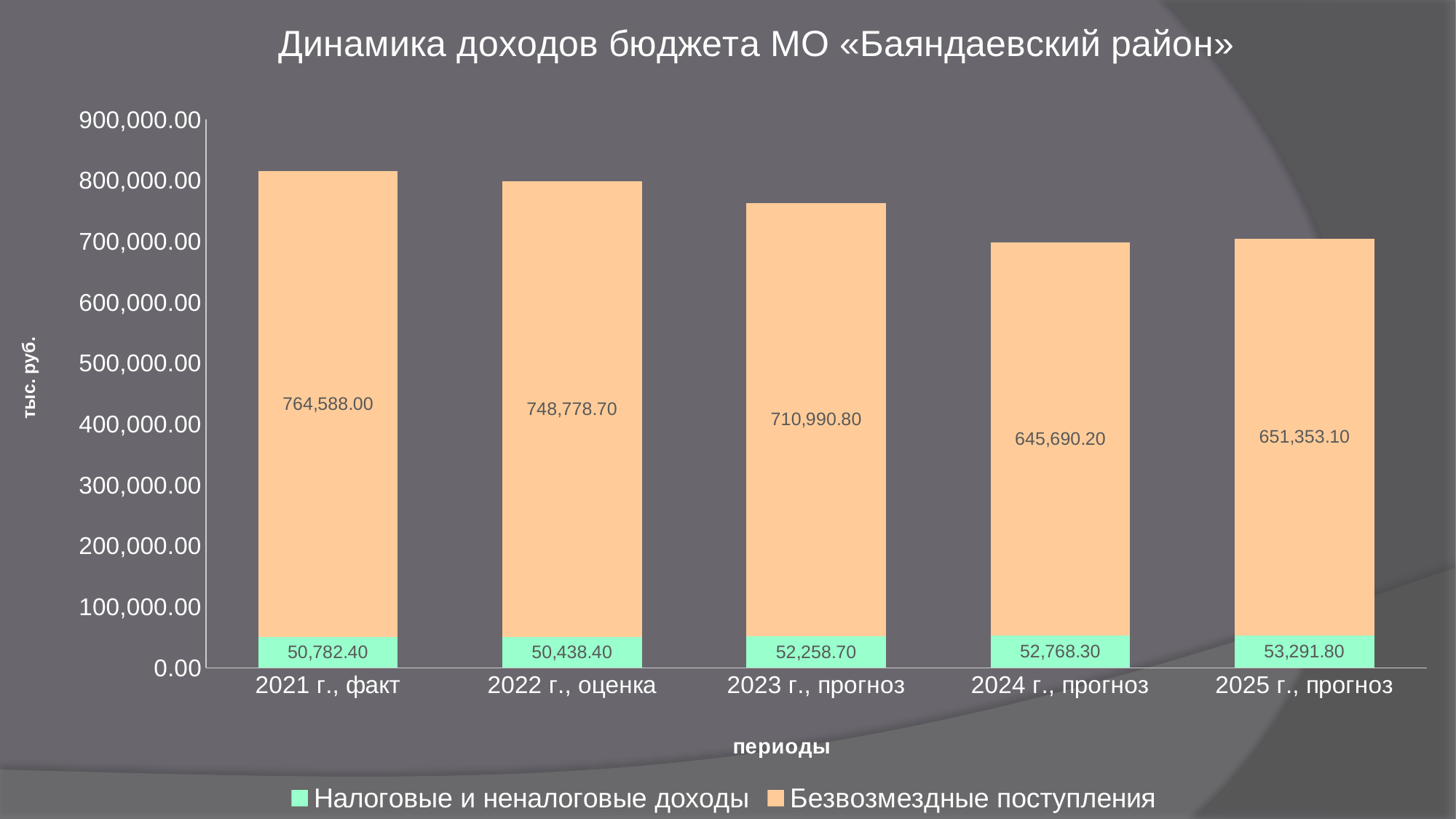
How many periods (categories) are shown on the x axis? 5 What is the value of Налоговые и неналоговые доходы for 2022 г., оценка? 50,438.40 In which period is Безвозмездные поступления the highest? 2021 г., факт What kind of chart is shown on the slide? Stacked bar chart In which period is Безвозмездные поступления the lowest? 2024 г., прогноз What is the total of the stacked bar for 2021 г., факт? 815,370.40 What is the difference between Безвозмездные поступления in 2021 г., факт and 2022 г., оценка? 15,809.30 In which period is Налоговые и неналоговые доходы the highest? 2025 г., прогноз Which is larger: Безвозмездные поступления in 2024 г., прогноз or in 2025 г., прогноз? 2025 г., прогноз What is the value of Безвозмездные поступления for 2023 г., прогноз? 710,990.80 Do the values of Безвозмездные поступления rise or fall from 2021 г., факт to 2024 г., прогноз? Fall How many series does the legend list? 2